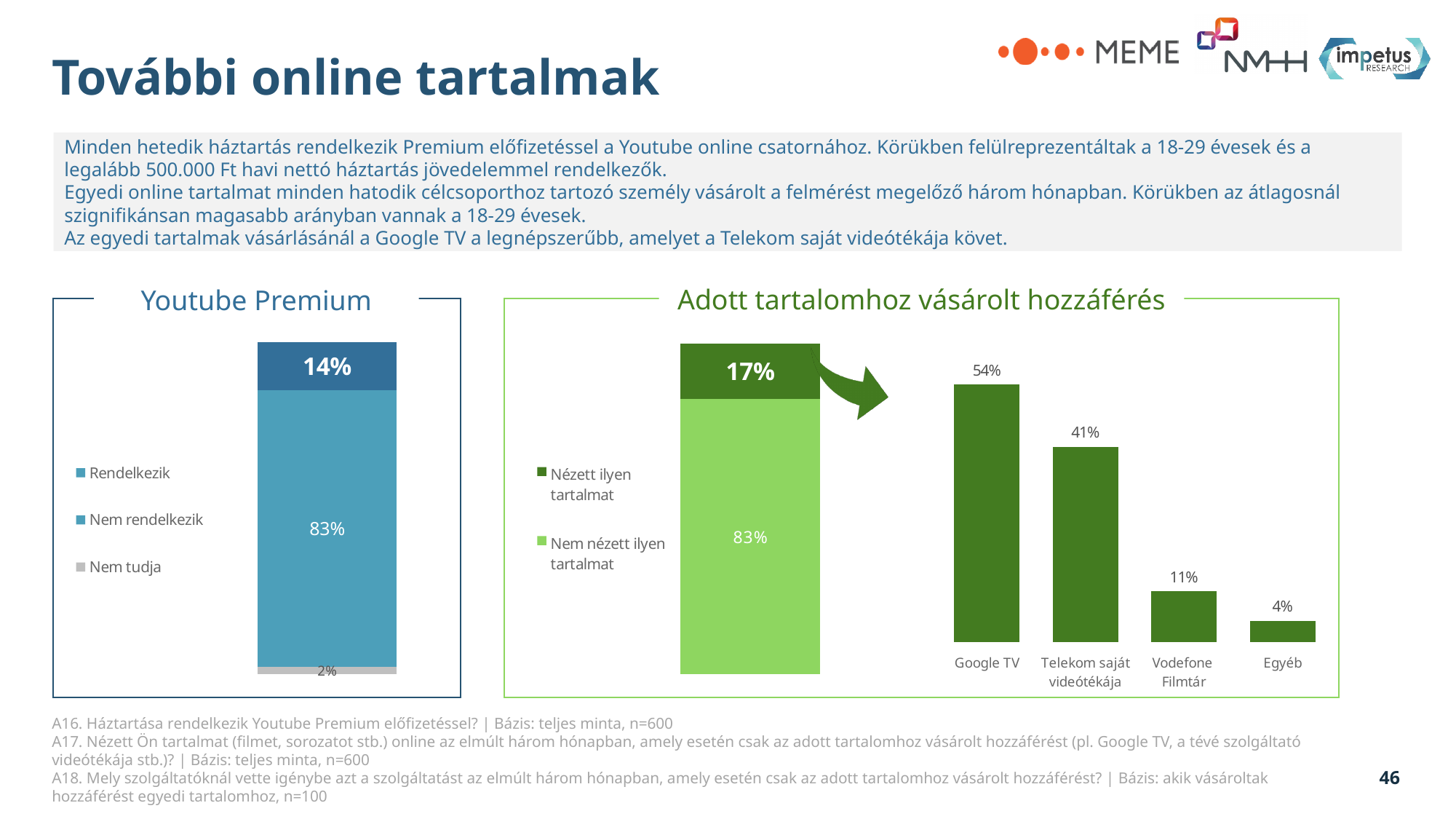
How many entries does the legend of the Youtube Premium chart list? 3 In the provider bar chart on the right, what is the difference between Google TV and Telekom saját videótékája? 13 percentage points In the Youtube Premium chart, what is the value for 'Nem rendelkezik'? 83% In the provider bar chart on the right, what is the value for Google TV? 54% In the provider bar chart on the right, how many categories are shown? 4 In the provider bar chart on the right, which category has the highest value? Google TV What type of chart is the provider chart on the right showing Google TV, Telekom saját videótékája, Vodefone Filmtár and Egyéb? Bar chart In the 'Adott tartalomhoz vásárolt hozzáférés' stacked bar, what is the value for 'Nem nézett ilyen tartalmat'? 83% In the 'Adott tartalomhoz vásárolt hozzáférés' stacked bar, what is the value for 'Nézett ilyen tartalmat'? 17% In the Youtube Premium chart, what share of households is labelled 'Rendelkezik'? 14% In the Youtube Premium chart, what is the value for 'Nem tudja'? 2% In the provider bar chart on the right, which category has the lowest value? Egyéb